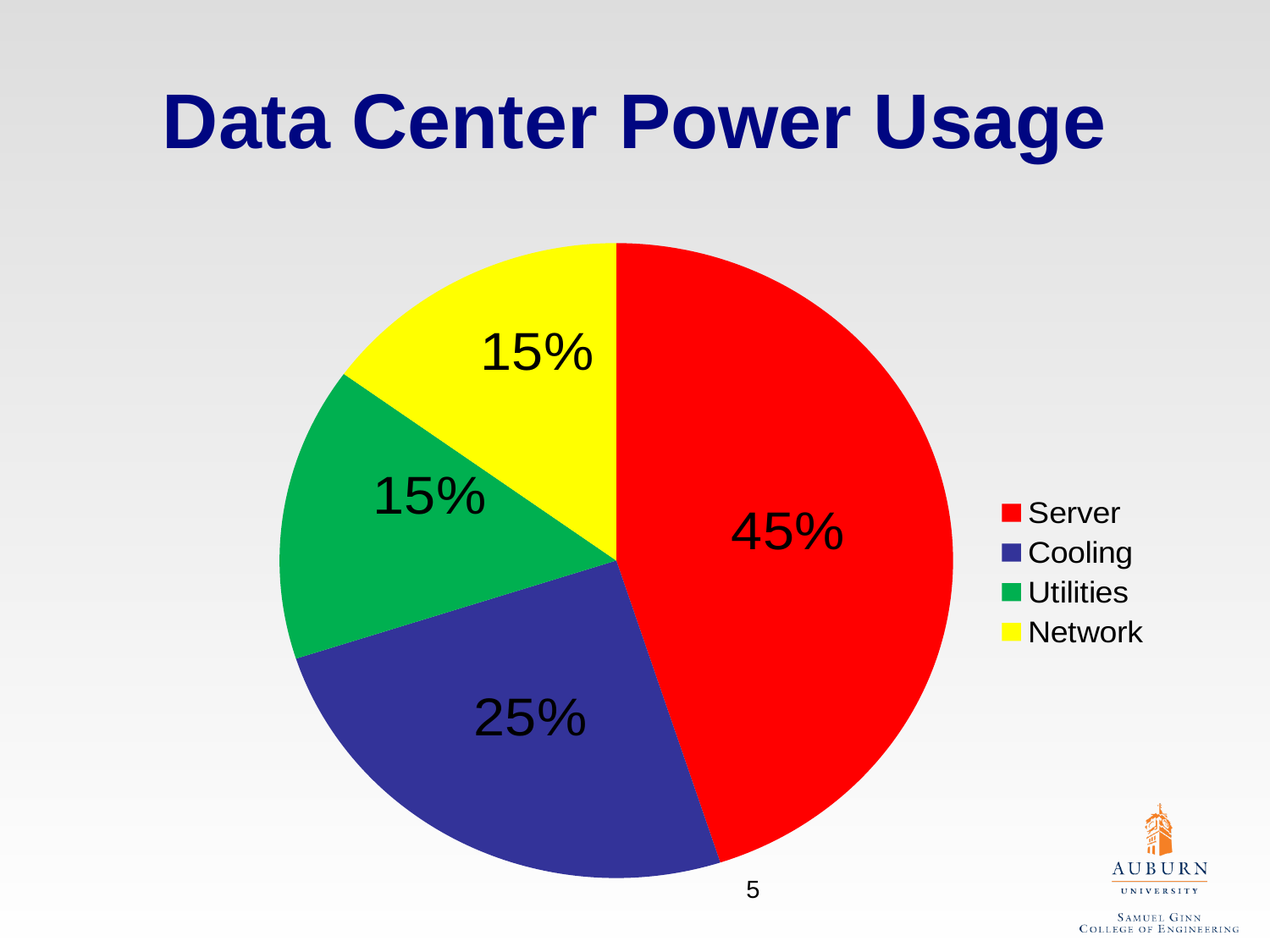
What is the title of the chart? Data Center Power Usage How many categories does the pie chart show? 4 How many entries does the legend list? 4 What share of data center power usage goes to Utilities? 15% What is the difference in percentage points between the Server share and the Cooling share? 20 Which category has the largest share of data center power usage? Server Which is larger, the share for Cooling or the share for Network? Cooling What share of data center power usage goes to Network? 15% What share of data center power usage goes to Cooling? 25% What colour represents Utilities in the pie chart? green What kind of chart is shown on the slide? pie chart What share of data center power usage goes to Server? 45%